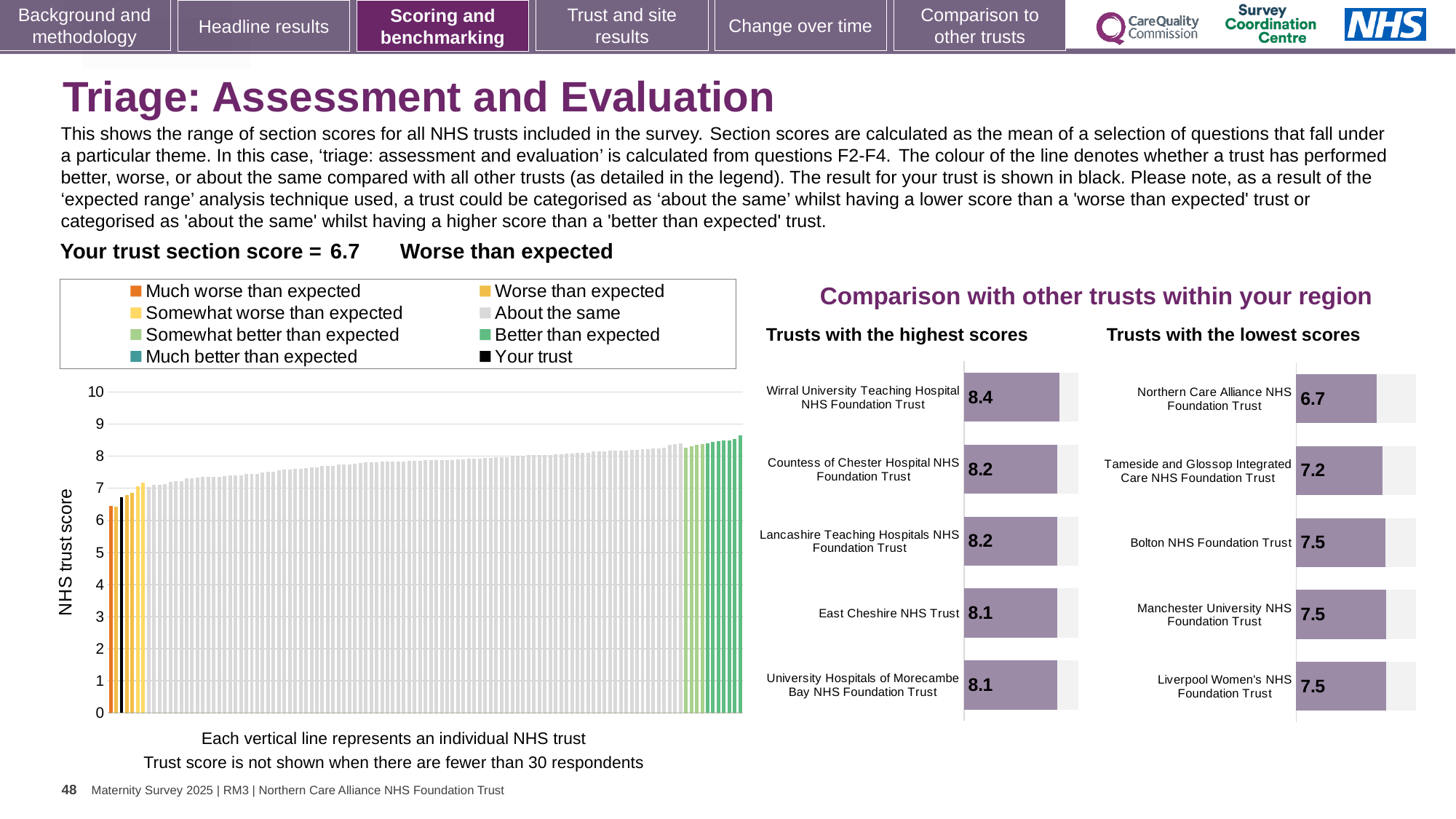
In the 'Trusts with the highest scores' chart, which has the larger score: Wirral University Teaching Hospital NHS Foundation Trust or East Cheshire NHS Trust? Wirral University Teaching Hospital NHS Foundation Trust In the NHS trust score chart on the left, is the value of the black bar (your trust) greater or less than 7? less How many entries does the legend of the NHS trust score chart on the left list? 8 In the 'Trusts with the lowest scores' chart, what is the score for Tameside and Glossop Integrated Care NHS Foundation Trust? 7.2 In the 'Trusts with the highest scores' chart, what is the score for Wirral University Teaching Hospital NHS Foundation Trust? 8.4 In the 'Trusts with the highest scores' chart, which trust has the highest score? Wirral University Teaching Hospital NHS Foundation Trust In the 'Trusts with the lowest scores' chart, what is the score for Bolton NHS Foundation Trust? 7.5 What is the difference between the score for Tameside and Glossop Integrated Care NHS Foundation Trust and the score for Northern Care Alliance NHS Foundation Trust in the 'Trusts with the lowest scores' chart? 0.5 How many trusts are shown in the 'Trusts with the highest scores' chart? 5 In the NHS trust score chart on the left, do the bar values rise or fall from left to right? Rise In the 'Trusts with the lowest scores' chart, which trust has the lowest score? Northern Care Alliance NHS Foundation Trust What kind of chart is the NHS trust score chart on the left of the slide? Bar chart